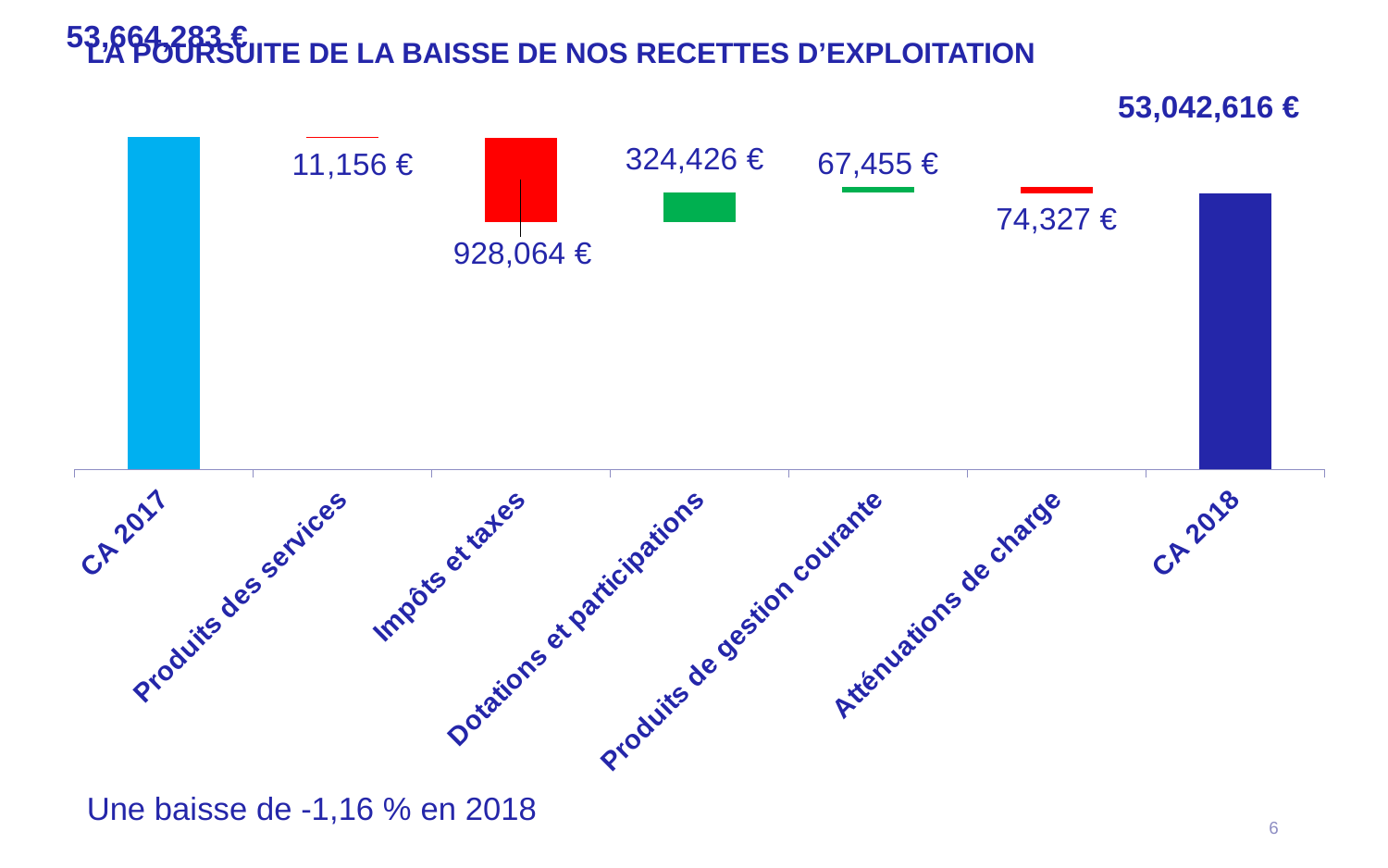
Which is larger, the value for Dotations et participations or the value for Produits de gestion courante? Dotations et participations What is the value shown for Atténuations de charge? 74,327 € What kind of chart is shown on the slide? Bar chart (waterfall) What is the value shown for Dotations et participations? 324,426 € What is the difference between the values for Impôts et taxes and Dotations et participations? 603,638 € What is the value shown for Produits des services? 11,156 € What is the value shown for Impôts et taxes? 928,064 € How many categories are shown on the x axis? 7 Among the intermediate categories between CA 2017 and CA 2018, which has the largest value? Impôts et taxes Among the intermediate categories between CA 2017 and CA 2018, which has the smallest value? Produits des services What is the value shown for CA 2018? 53,042,616 € What is the difference between the values for Atténuations de charge and Produits de gestion courante? 6,872 €